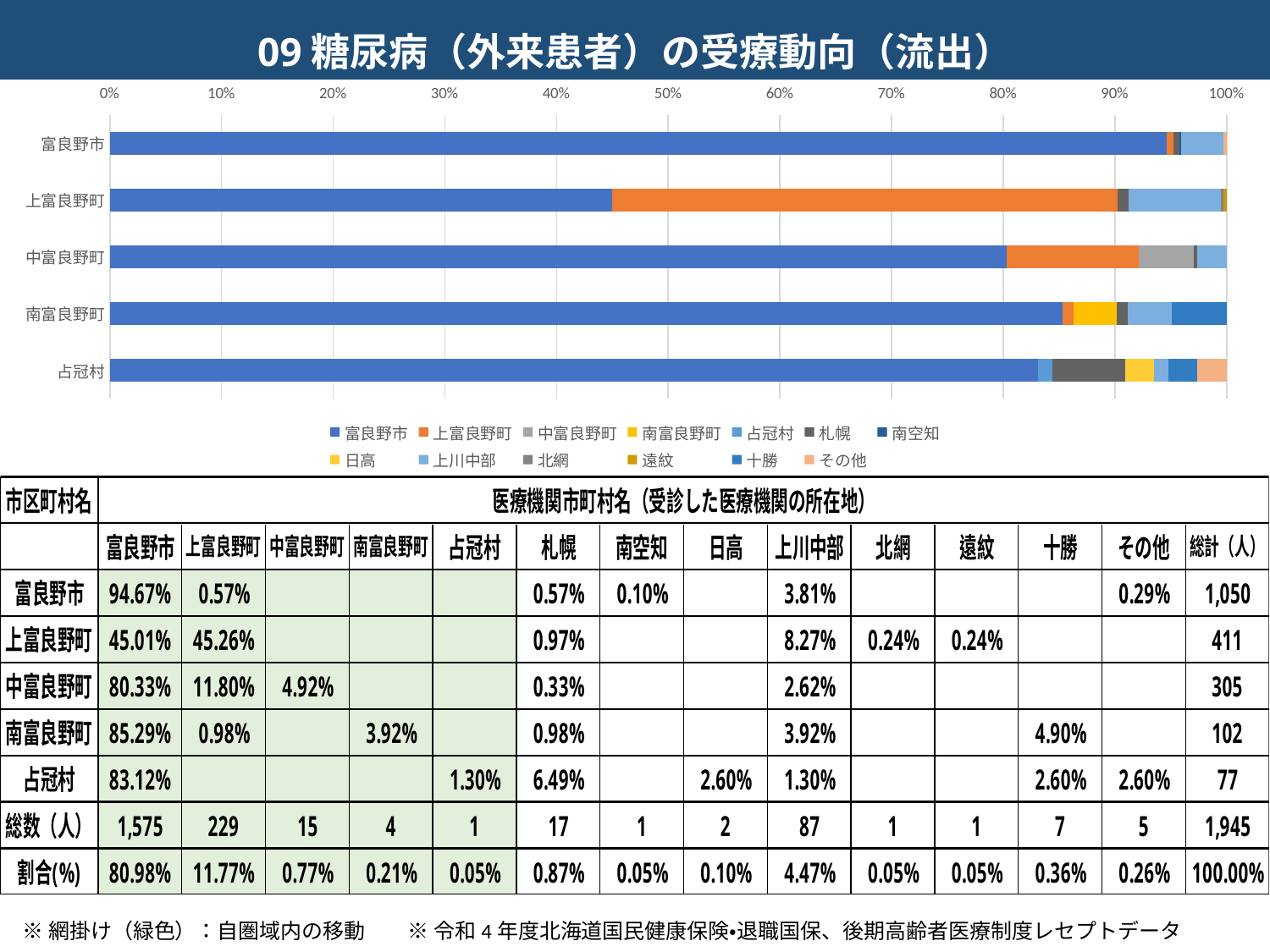
What is the title of the chart on the slide? 09 糖尿病（外来患者）の受療動向（流出） Which municipality's bar has the smallest 富良野市 segment? 上富良野町 How many series does the chart legend list? 13 According to the table, what is the 総計 (total number of people) for 占冠村? 77 In the chart, is the 富良野市 share of the 上富良野町 bar greater or less than 50%? less According to the table, what percentage of 富良野市 patients went to 上川中部? 3.81% In the chart, is the 富良野市 share of the 中富良野町 bar greater or less than 70%? greater Which municipality's bar has the largest 富良野市 segment? 富良野市 How many municipalities (categories) are plotted on the vertical axis of the chart? 5 In the chart, is the 富良野市 share of the 富良野市 bar greater or less than 90%? greater What kind of chart is shown on the slide? stacked bar chart Is the 上富良野町 segment larger in the 上富良野町 bar or in the 中富良野町 bar? 上富良野町